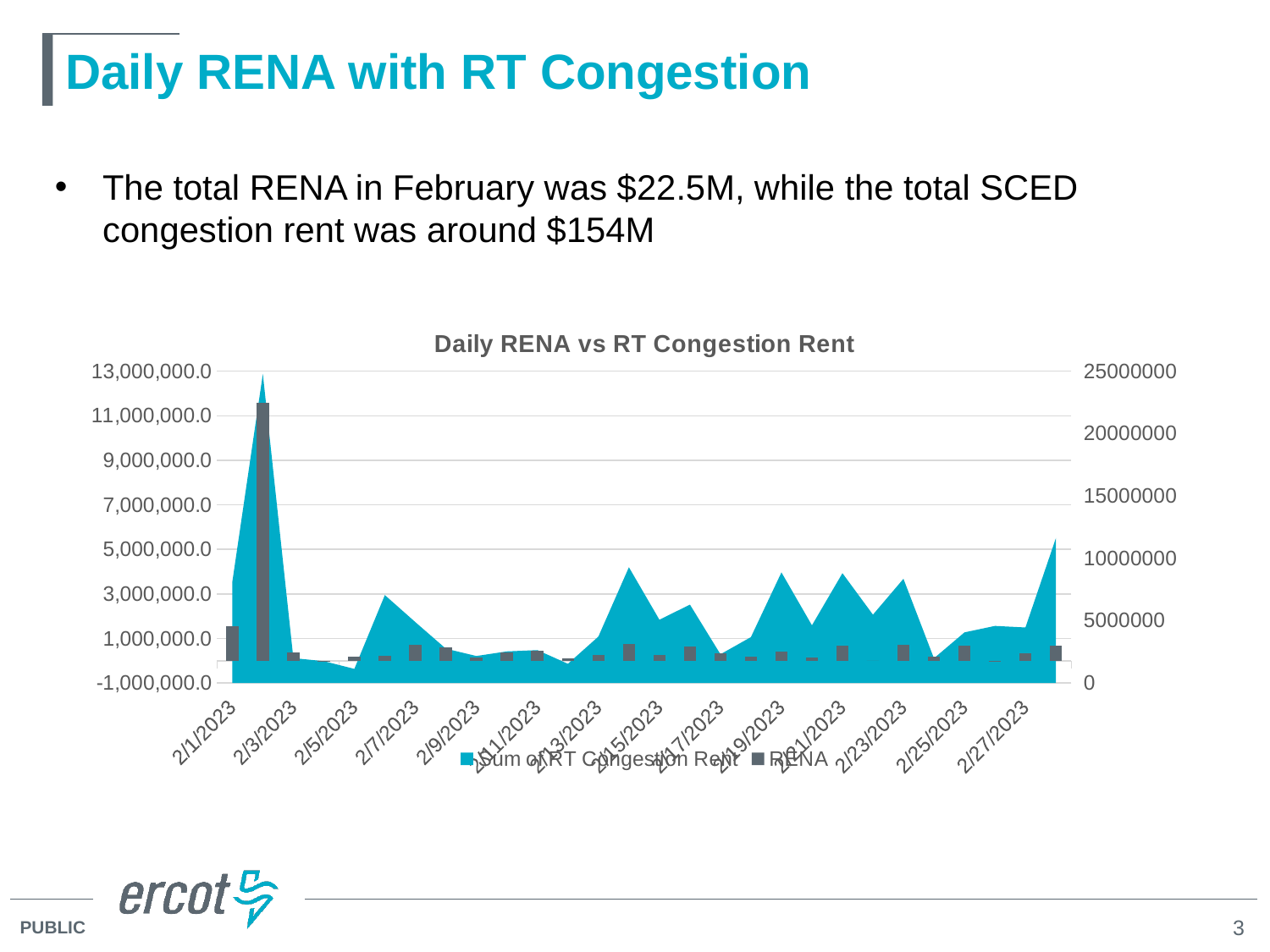
Which date has the larger RENA bar, 2/1/2023 or 2/3/2023? 2/1/2023 What is the title of the chart? Daily RENA vs RT Congestion Rent What kind of chart is used to plot the Sum of RT Congestion Rent series? Area chart What kind of chart is used to plot the RENA series? Bar chart What are the two series named in the chart legend? Sum of RT Congestion Rent and RENA How many series does the chart legend list? 2 On which date is the RENA bar the tallest? 2/2/2023 Is the peak value of the Sum of RT Congestion Rent greater or less than 11,000,000.0 on the left axis? greater Is the tallest RENA bar greater or less than 9,000,000.0 on the left axis? greater Does the Sum of RT Congestion Rent rise or fall between 2/2/2023 and 2/5/2023? fall How many date labels are shown on the x axis? 14 On which date does the Sum of RT Congestion Rent reach its highest value? 2/2/2023